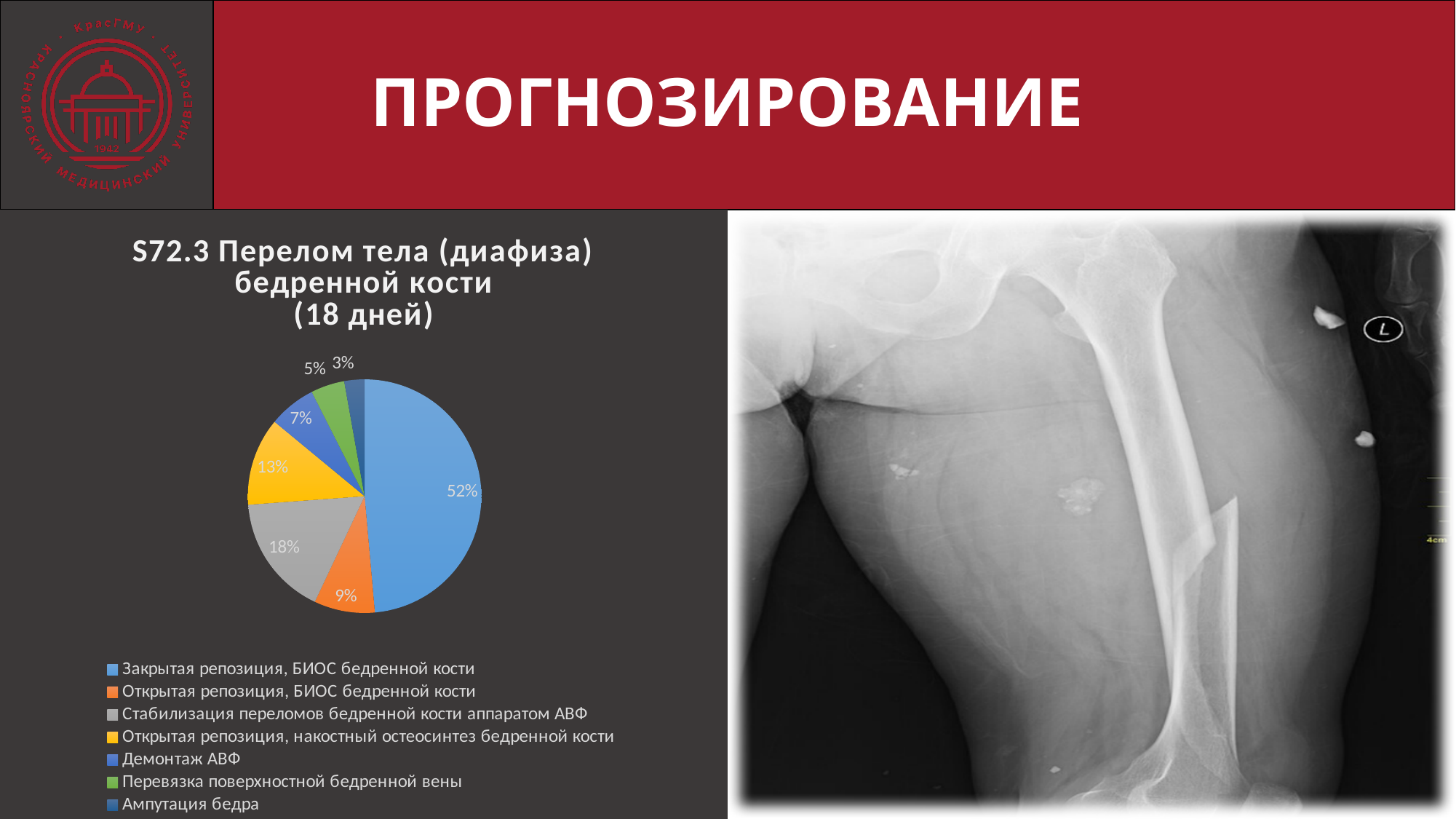
Which category has the smallest slice of the pie? Ампутация бедра How many slices does the pie chart have? 7 How many entries does the legend of the pie chart list? 7 What share of the pie does 'Открытая репозиция, накостный остеосинтез бедренной кости' have? 13% What share of the pie does 'Ампутация бедра' have? 3% Which is larger: the slice for 'Демонтаж АВФ' or the slice for 'Перевязка поверхностной бедренной вены'? Демонтаж АВФ What kind of chart is shown on the slide? pie chart What is the difference in percentage points between 'Закрытая репозиция, БИОС бедренной кости' and 'Открытая репозиция, БИОС бедренной кости'? 43 Which category has the largest slice of the pie? Закрытая репозиция, БИОС бедренной кости What share of the pie does 'Стабилизация переломов бедренной кости аппаратом АВФ' have? 18% What is the title of the pie chart? S72.3 Перелом тела (диафиза) бедренной кости (18 дней)